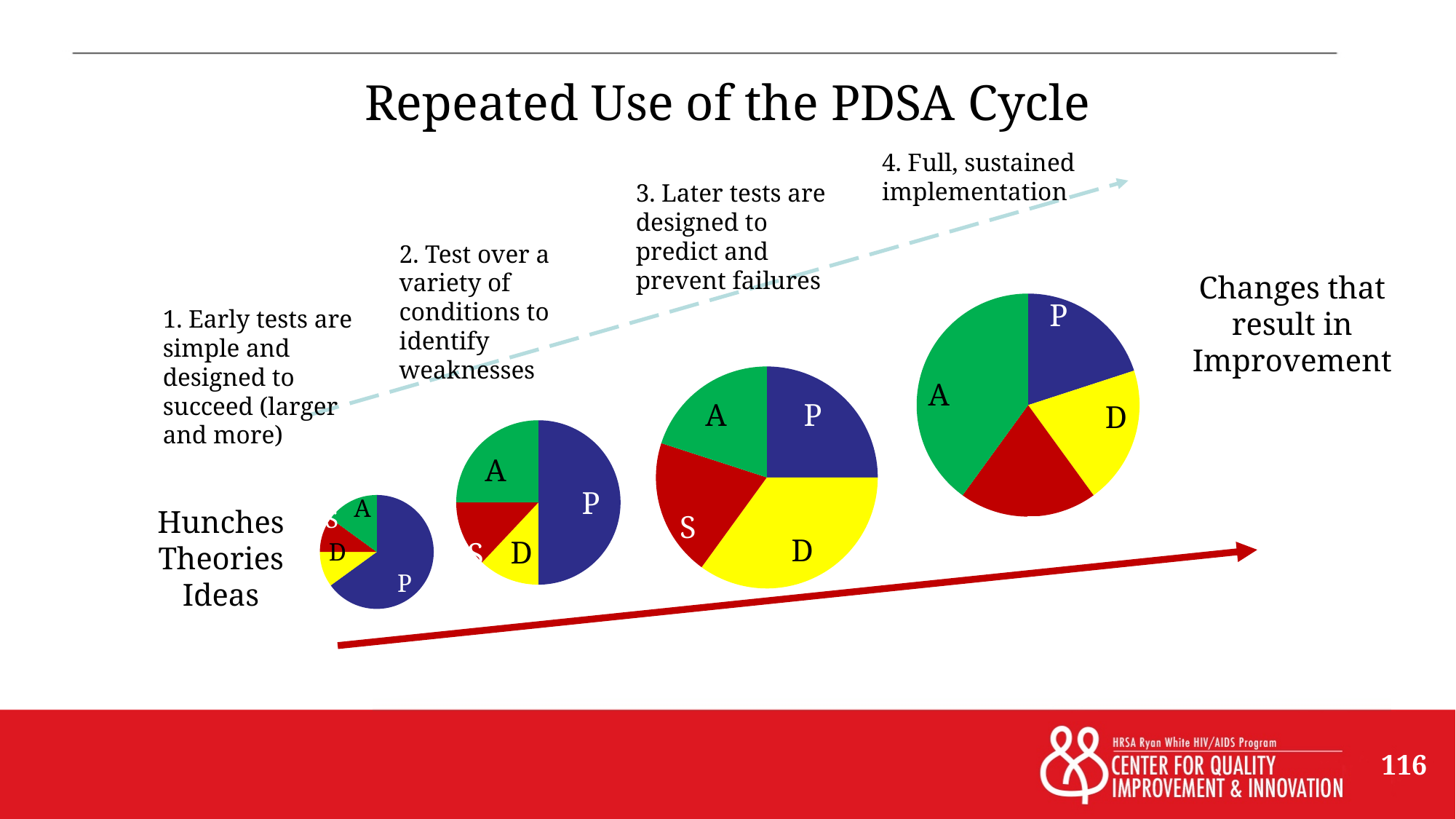
What is the title of the slide containing the pie charts? Repeated Use of the PDSA Cycle In the third pie chart from the left, which slice is larger, D or A? D What colour is the P slice in the pie charts? blue In the largest (rightmost) pie chart, which slice is the largest? A In the largest (rightmost) pie chart, which slice is larger, A or D? A In the second pie chart from the left, which slice is the largest? P How many pie charts are shown on the slide? 4 How many slices does the largest (rightmost) pie chart have? 4 In the smallest (leftmost) pie chart, which slice is the largest? P What kind of chart is used to represent each PDSA cycle on the slide? pie chart In the smallest (leftmost) pie chart, which slice is larger, P or S? P